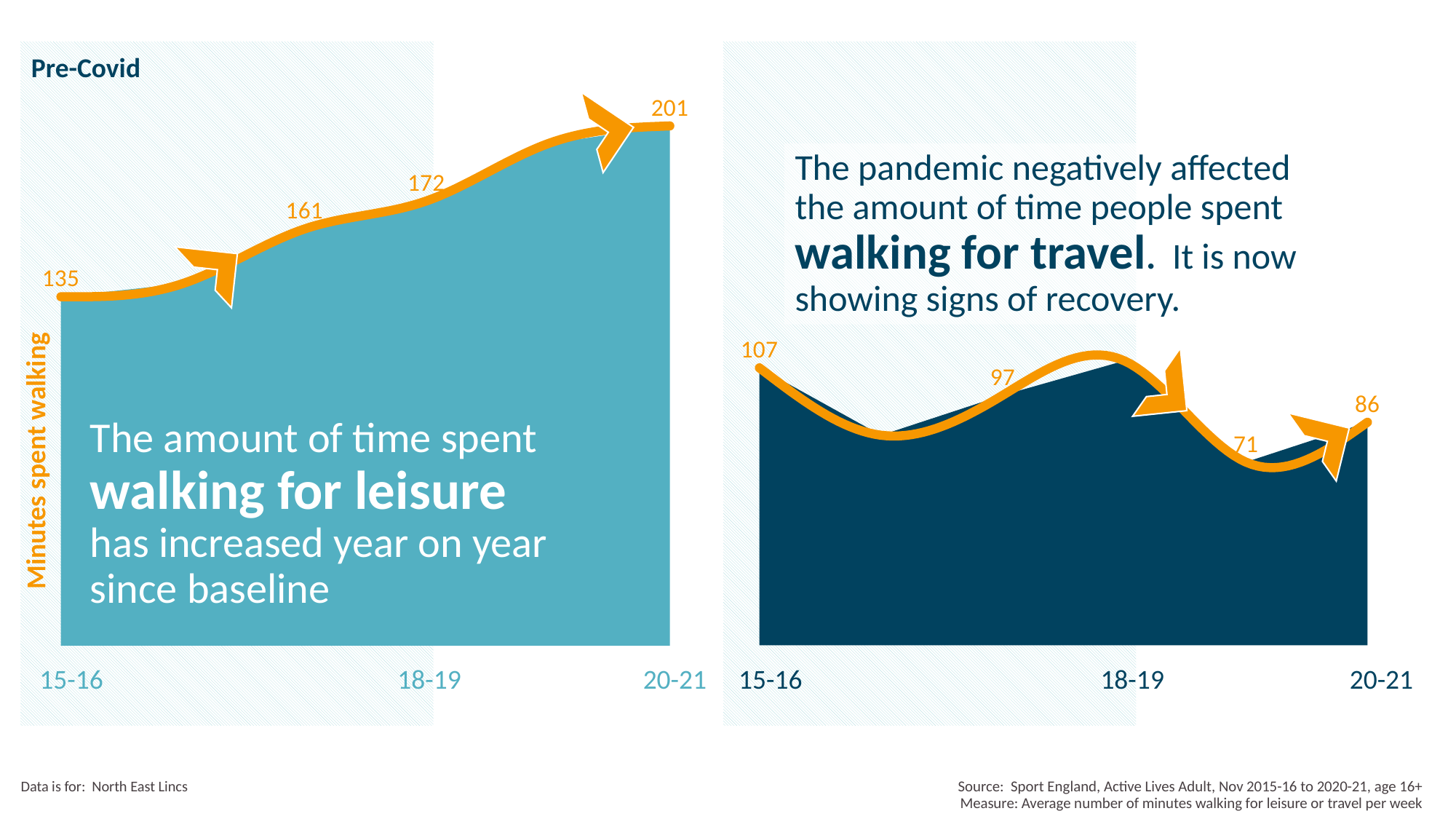
In the walking for travel chart on the right, what is the value for 20-21? 86 In the walking for travel chart on the right, what is the difference between the 15-16 value and the 20-21 value? 21 In the walking for leisure chart on the left, by how much did the value increase from 15-16 to 20-21? 66 In the walking for leisure chart on the left, what is the value for 15-16? 135 What is the y-axis label on the walking for leisure chart on the left? Minutes spent walking How many data labels are printed on the walking for travel chart on the right? 4 For 15-16, which is larger: minutes walking for leisure (left chart) or minutes walking for travel (right chart)? walking for leisure In the walking for leisure chart on the left, which year has the highest value? 20-21 In the walking for leisure chart on the left, what is the value for 20-21? 201 In the walking for travel chart on the right, what is the lowest labelled value? 71 In the walking for leisure chart on the left, do the values rise or fall from 15-16 to 20-21? rise In the walking for travel chart on the right, what is the value for 15-16? 107